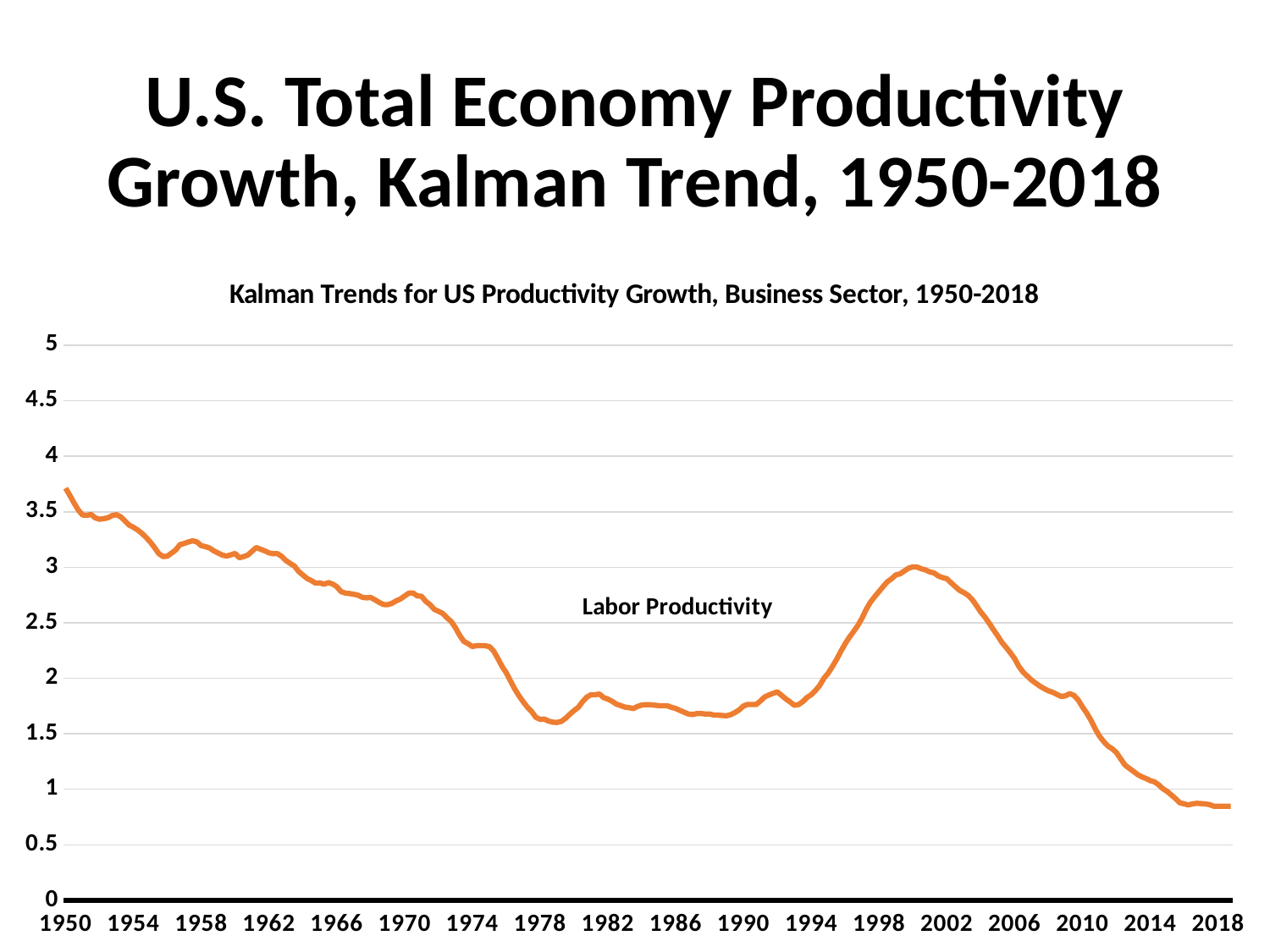
Is the value for 2000 greater or less than 2.5? greater What kind of chart is shown on the slide? Line chart Is the value for 1970 greater or less than 3? less Which year has the higher value, 1950 or 2018? 1950 Is the value for 1950 greater or less than 3.5? greater What is the name of the series plotted on the chart? Labor Productivity What is the title of the chart? Kalman Trends for US Productivity Growth, Business Sector, 1950-2018 Overall, does the Labor Productivity trend rise or fall from 1950 to 2018? fall Which year has the higher value, 1990 or 2000? 2000 How many series are plotted on the chart? 1